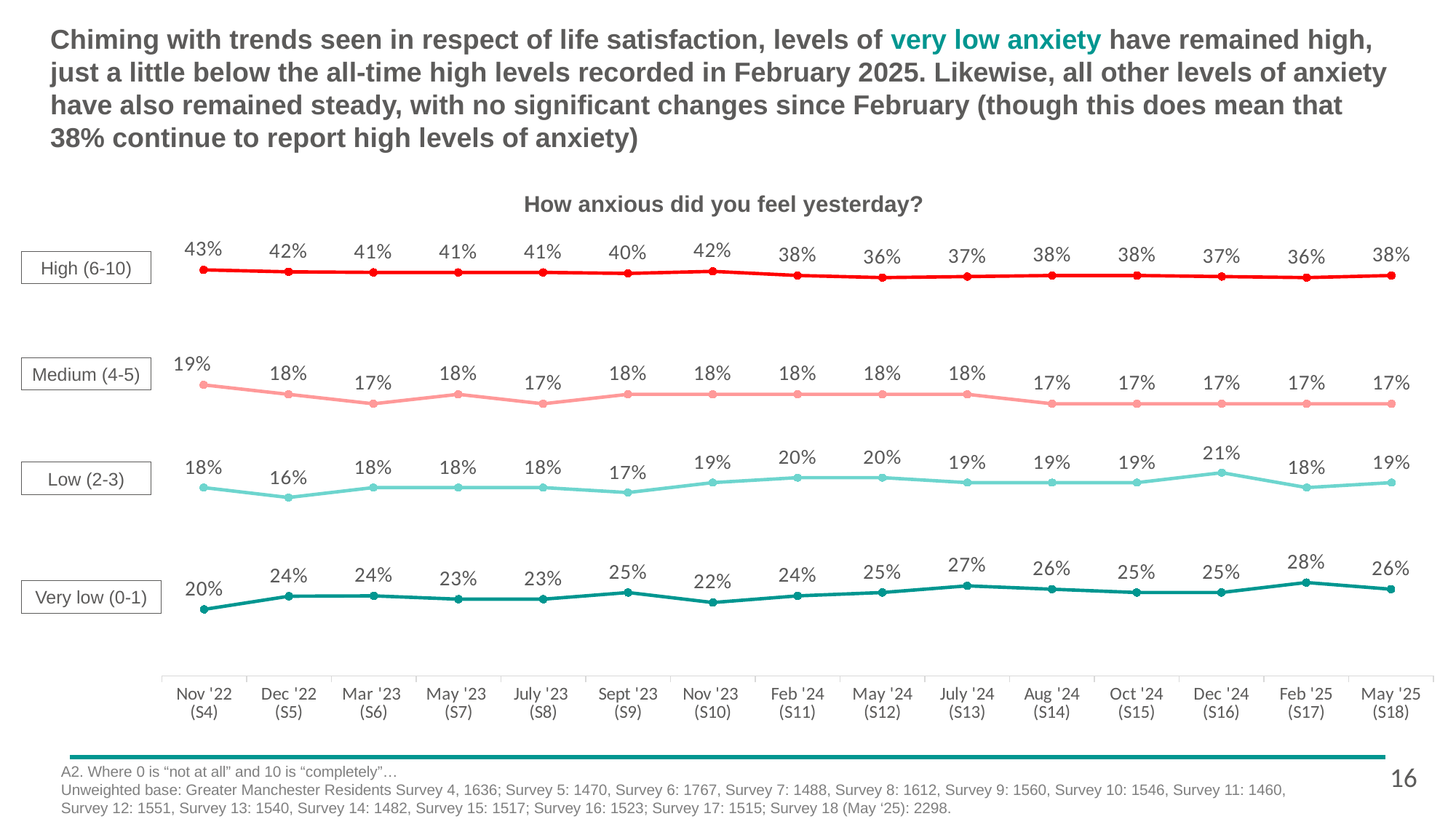
What kind of chart is shown on the slide? Line chart What is the value for Medium (4-5) in Nov '22 (S4)? 19% What is the difference between the High (6-10) value in Nov '22 (S4) and in May '25 (S18)? 5 percentage points What is the value for Low (2-3) in Dec '24 (S16)? 21% What is the title of the chart? How anxious did you feel yesterday? How many survey waves are shown on the x axis? 15 What is the value for Very low (0-1) in Feb '25 (S17)? 28% How many series are plotted on the chart? 4 In which survey wave is the Very low (0-1) series at its lowest? Nov '22 (S4) What is the value for High (6-10) in May '25 (S18)? 38% In which survey wave is the High (6-10) series at its highest? Nov '22 (S4) Which is larger in May '25 (S18): the Very low (0-1) value or the Low (2-3) value? Very low (0-1)